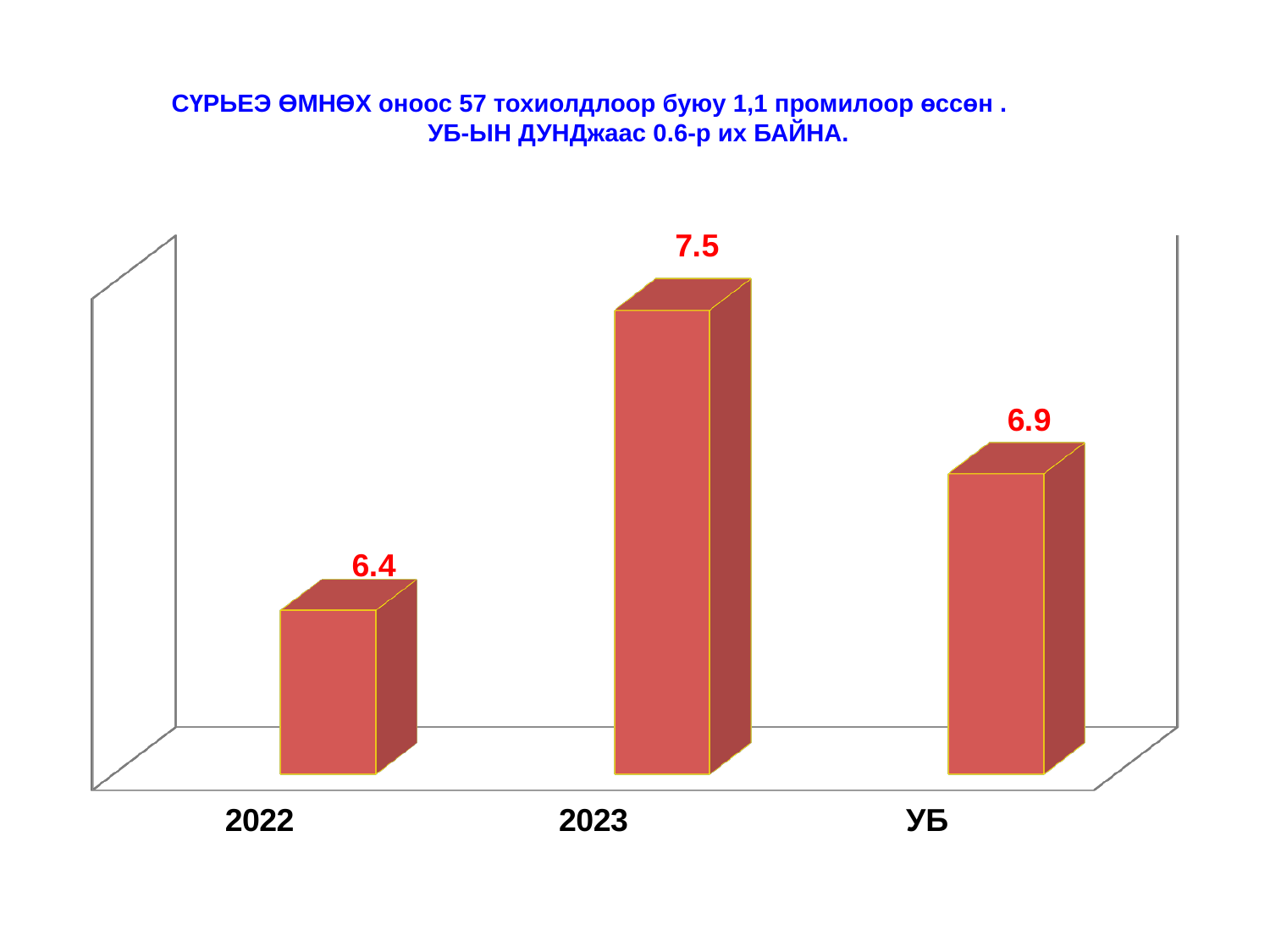
Which is larger, the value for УБ or the value for 2022? УБ What is the value for 2022? 6.4 What is the value for 2023? 7.5 What is the difference between the values for 2023 and 2022? 1.1 How many categories are shown on the chart? 3 Does the value rise or fall from 2022 to 2023? rise What is the difference between the values for 2023 and УБ? 0.6 Which category has the lowest value? 2022 What kind of chart is shown on the slide? bar chart What is the value for УБ? 6.9 What colour are the bars on the chart? red Which category has the highest value? 2023